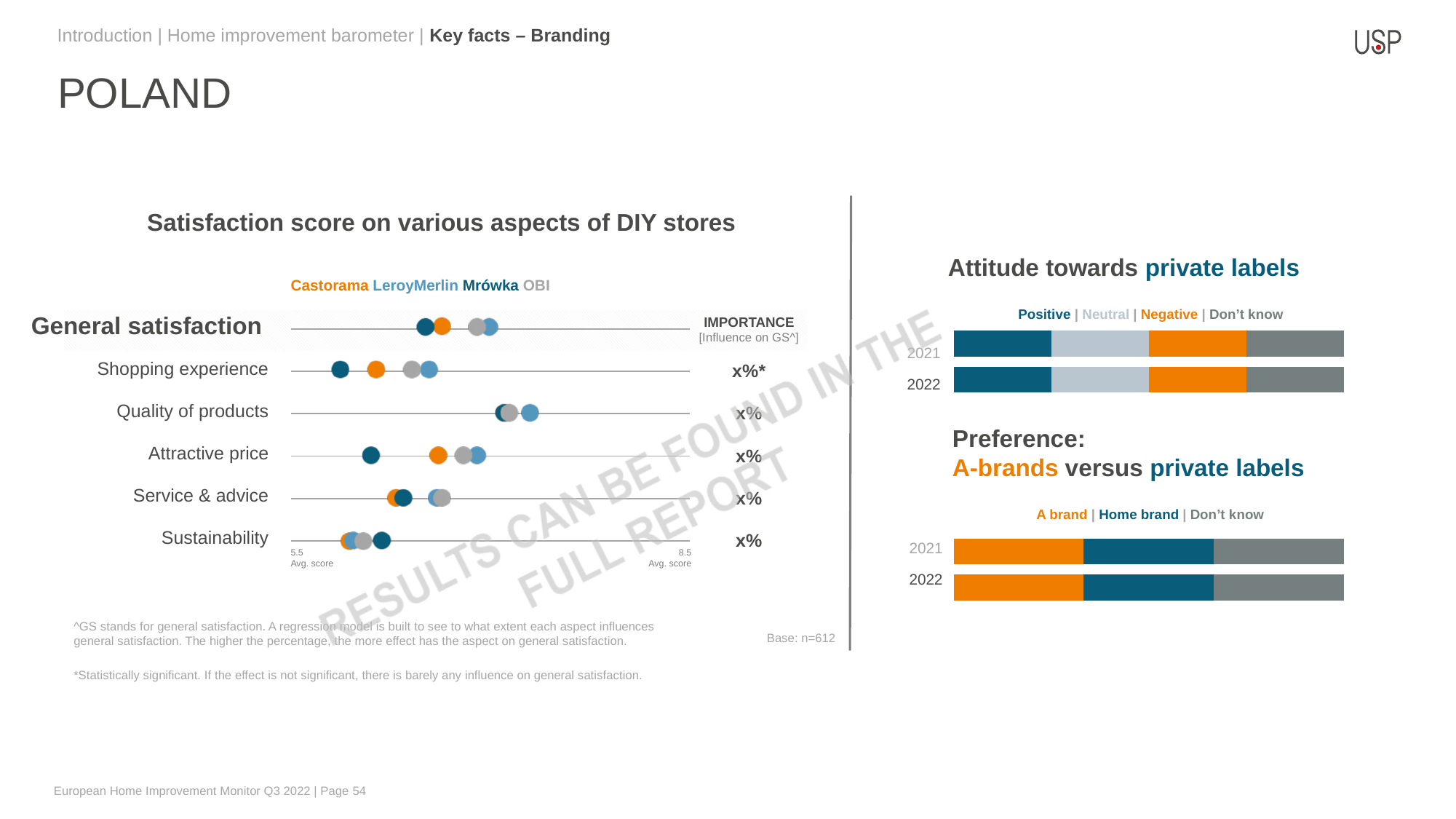
In the 'Satisfaction score on various aspects of DIY stores' chart, how many DIY stores does the legend list? 4 In the 'Satisfaction score on various aspects of DIY stores' chart, how many aspects (rows) are plotted? 6 In the 'Satisfaction score on various aspects of DIY stores' chart, what are the minimum and maximum average scores shown on the axis? 5.5 and 8.5 In the 'Attitude towards private labels' chart, how many categories does the legend list? 4 In the 'Satisfaction score on various aspects of DIY stores' chart, for General satisfaction, which scores higher: LeroyMerlin or Mrówka? LeroyMerlin In the 'Satisfaction score on various aspects of DIY stores' chart, which store has the lowest score for Attractive price? Mrówka What kind of chart is the 'Preference: A-brands versus private labels' chart? Stacked bar chart In the 'Satisfaction score on various aspects of DIY stores' chart, for Attractive price, which scores higher: OBI or Mrówka? OBI In the 'Satisfaction score on various aspects of DIY stores' chart, which store has the lowest score for Shopping experience? Mrówka In the 'Satisfaction score on various aspects of DIY stores' chart, for Shopping experience, which scores higher: Castorama or Mrówka? Castorama In the 'Attitude towards private labels' chart, which years are shown? 2021 and 2022 In the 'Preference: A-brands versus private labels' chart, how many categories does the legend list? 3